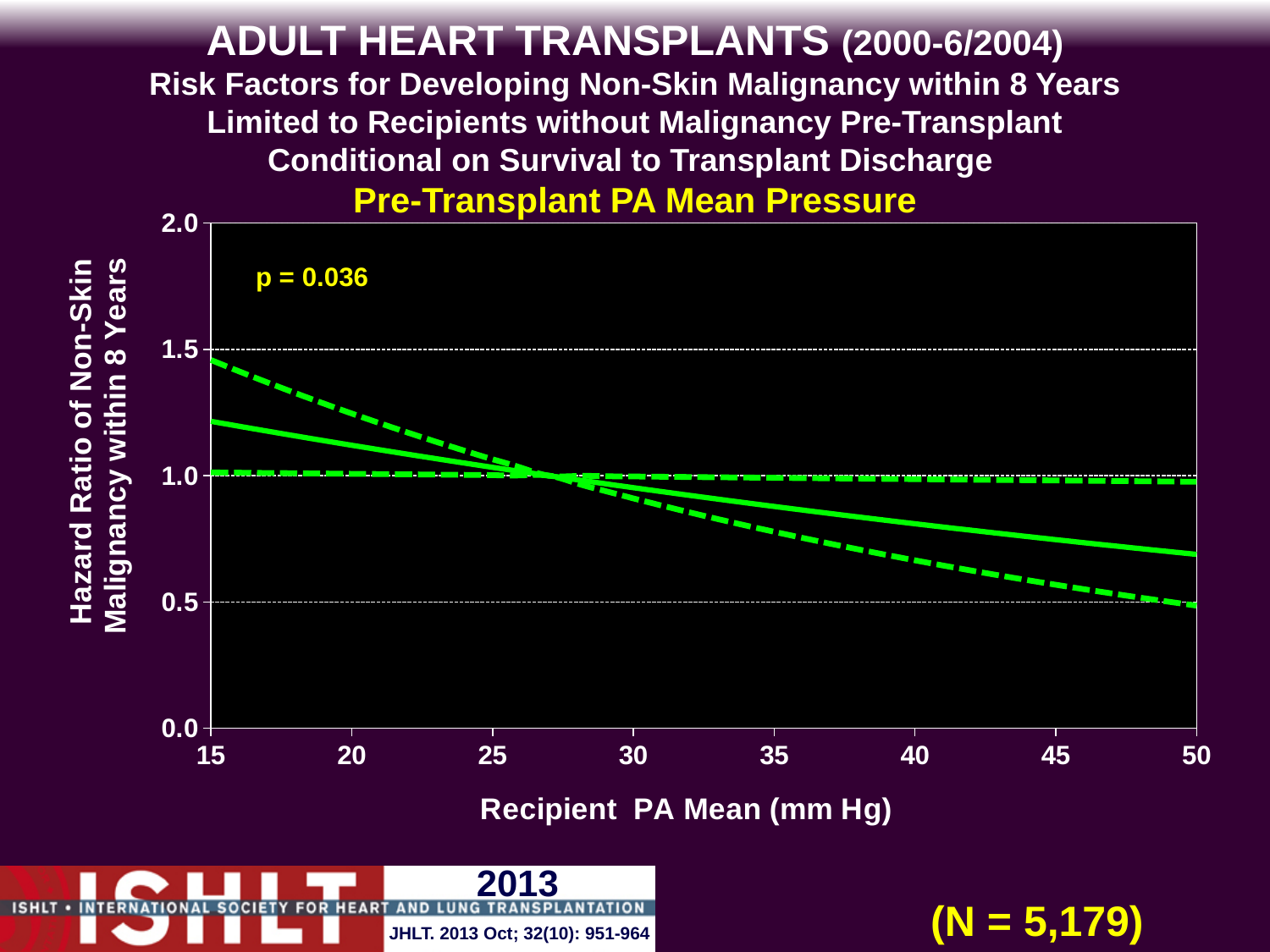
Is the hazard ratio on the solid line at a Recipient PA Mean of 15 mm Hg greater or less than 1.0? greater What is the label of the x axis? Recipient PA Mean (mm Hg) How many lines are plotted on the chart? 3 Is the hazard ratio on the solid line at a Recipient PA Mean of 40 mm Hg greater or less than 0.5? greater What is the p-value shown on the chart? p = 0.036 Is the hazard ratio on the solid line higher at a Recipient PA Mean of 20 mm Hg or at 45 mm Hg? 20 mm Hg What kind of chart is shown on the slide? line chart Is the hazard ratio on the solid line at a Recipient PA Mean of 20 mm Hg greater or less than 1.5? less Does the solid line for hazard ratio rise or fall as Recipient PA Mean increases from 15 to 50 mm Hg? fall